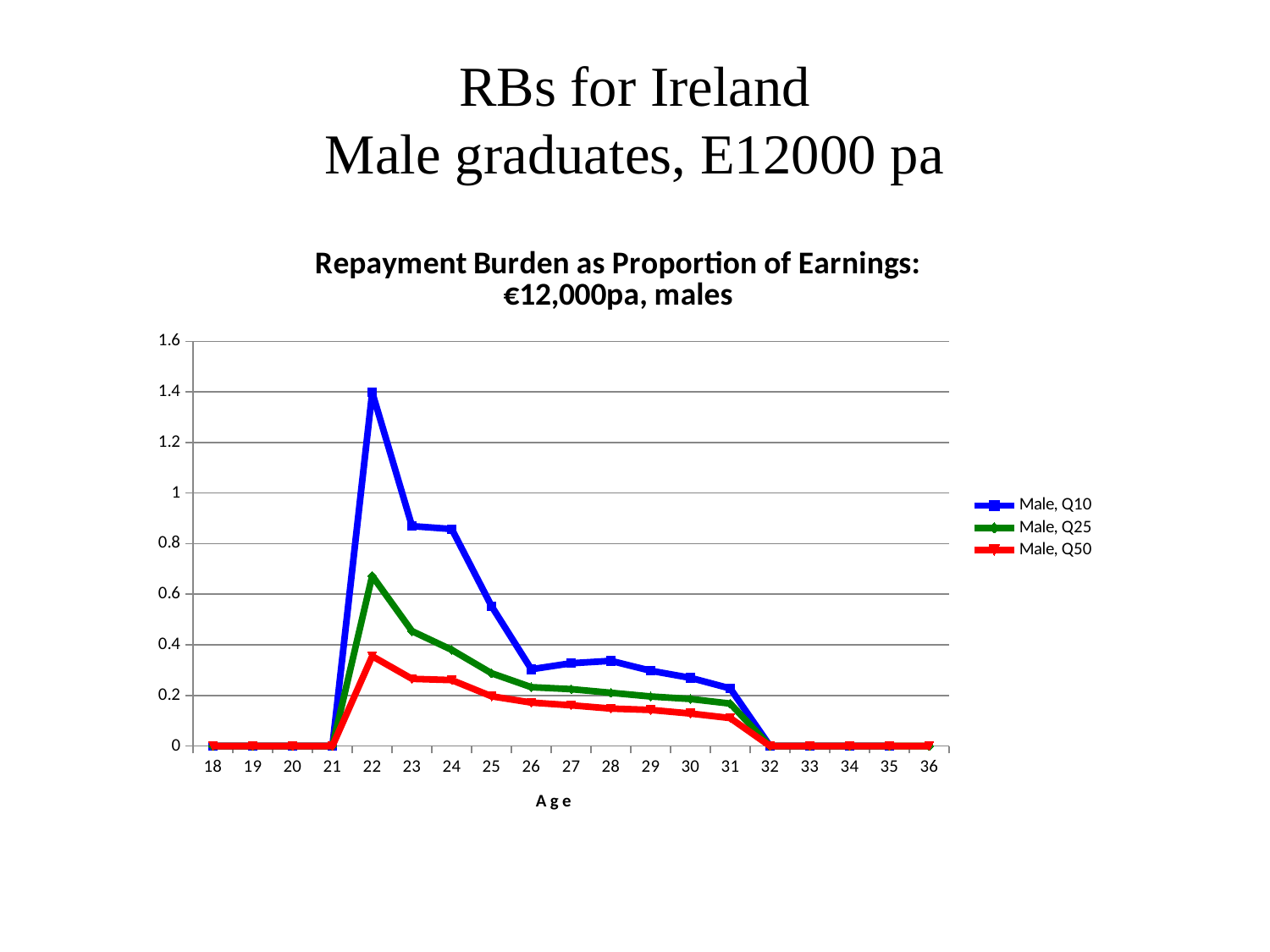
At age 24, which series has the larger value, Male, Q10 or Male, Q25? Male, Q10 What is the value for Male, Q50 at age 33? 0 How many series does the legend list? 3 Is the value for Male, Q50 at age 22 greater or less than 0.2? greater Is the value for Male, Q10 at age 22 greater or less than 1.2? greater Does the Male, Q10 series rise or fall from age 22 to age 31? fall At which age does the Male, Q10 series reach its highest value? 22 How many ages are plotted along the x axis? 19 Is the value for Male, Q25 at age 22 greater or less than 0.6? greater What kind of chart is shown on the slide? line chart What is the value for Male, Q10 at age 18? 0